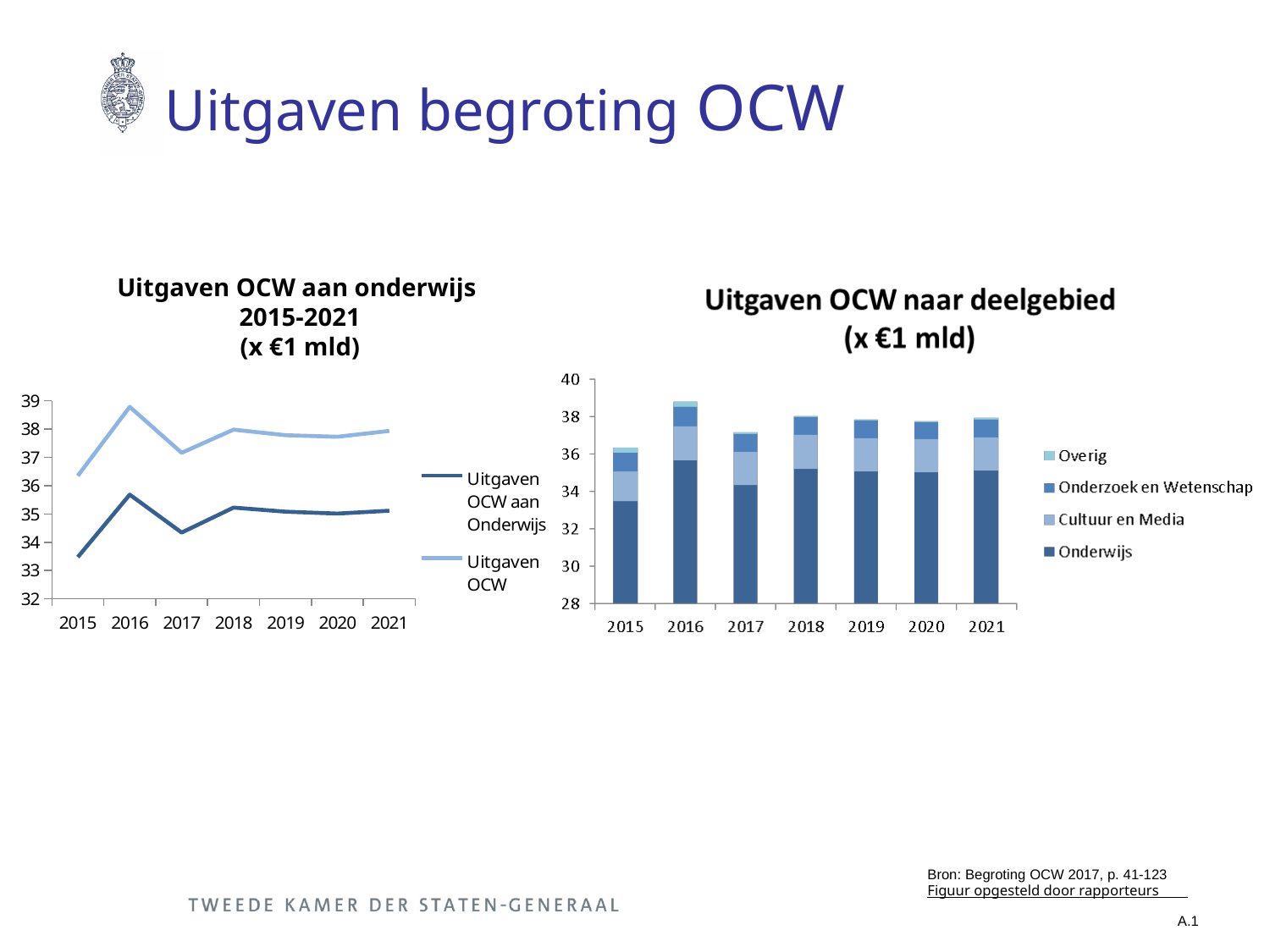
In the left chart 'Uitgaven OCW aan onderwijs 2015-2021', in which year is the 'Uitgaven OCW' line highest? 2016 In the left chart 'Uitgaven OCW aan onderwijs 2015-2021', is the 'Uitgaven OCW aan Onderwijs' value for 2017 greater or less than 35? less In the right chart 'Uitgaven OCW naar deelgebied', how many series does the legend list? 4 In the right chart 'Uitgaven OCW naar deelgebied', which year has the tallest stacked bar? 2016 In the left chart 'Uitgaven OCW aan onderwijs 2015-2021', how many series does the legend list? 2 In the left chart 'Uitgaven OCW aan onderwijs 2015-2021', in which year is the 'Uitgaven OCW aan Onderwijs' line lowest? 2015 What kind of chart is the right chart, 'Uitgaven OCW naar deelgebied'? bar chart In the right chart 'Uitgaven OCW naar deelgebied', is the total stacked bar for 2015 greater or less than 37? less In the left chart 'Uitgaven OCW aan onderwijs 2015-2021', is the 'Uitgaven OCW' value for 2015 greater or less than 37? less In the right chart 'Uitgaven OCW naar deelgebied', which legend entry is shown in the darkest blue at the bottom of each bar? Onderwijs What kind of chart is the left chart, 'Uitgaven OCW aan onderwijs 2015-2021'? line chart In the right chart 'Uitgaven OCW naar deelgebied', how many years are shown on the x axis? 7